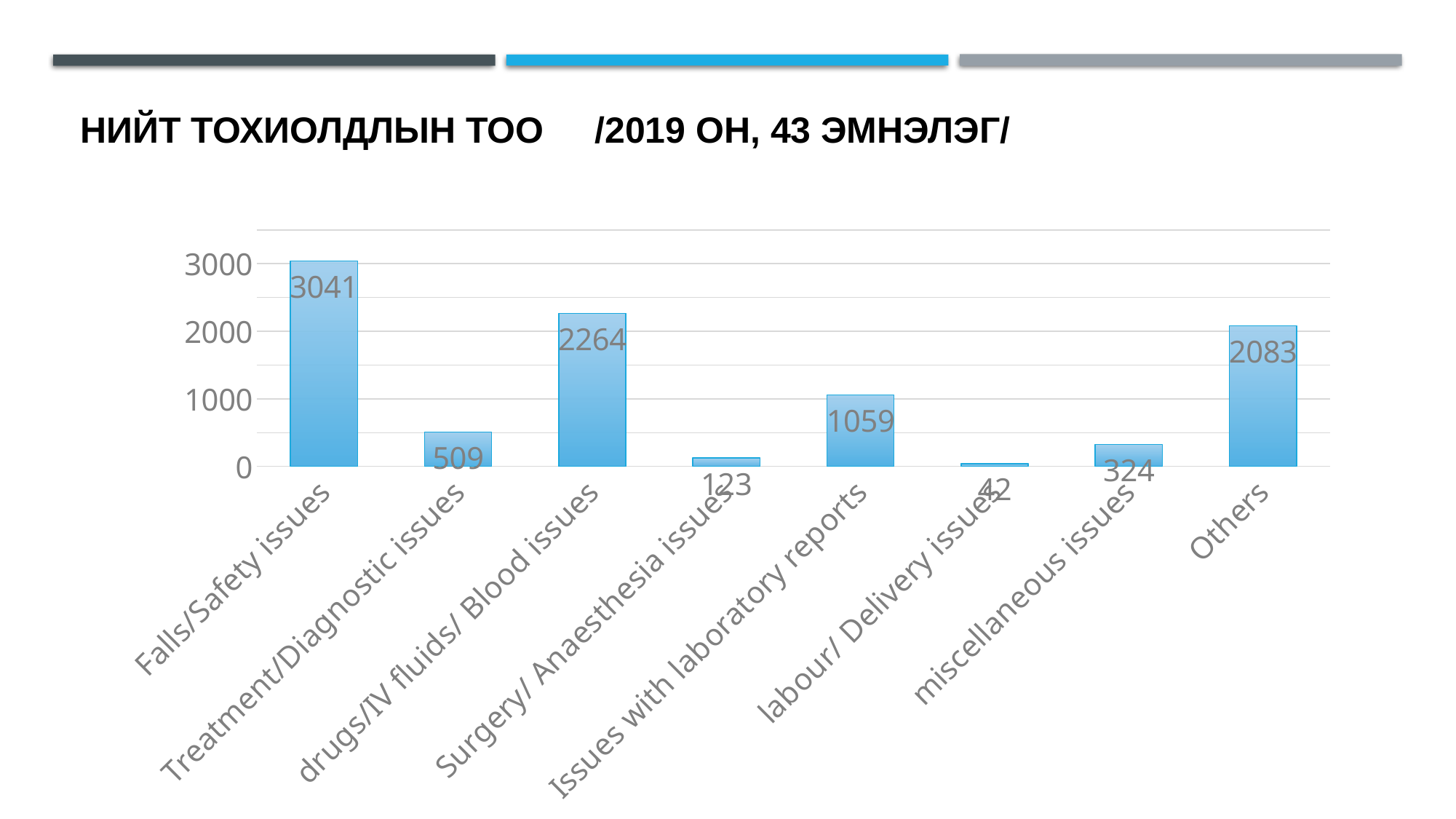
What is the value for Treatment/Diagnostic issues? 509 What is the value for Falls/Safety issues? 3041 What is the value for Issues with laboratory reports? 1059 Which category has the highest value? Falls/Safety issues Which is larger, Others or Issues with laboratory reports? Others Is the value for miscellaneous issues greater or less than 1000? less How many categories are shown on the x axis? 8 What is the value for drugs/IV fluids/ Blood issues? 2264 What is the difference between Falls/Safety issues and drugs/IV fluids/ Blood issues? 777 Which category has the lowest value? labour/ Delivery issues What kind of chart is this? bar chart What is the value for Others? 2083